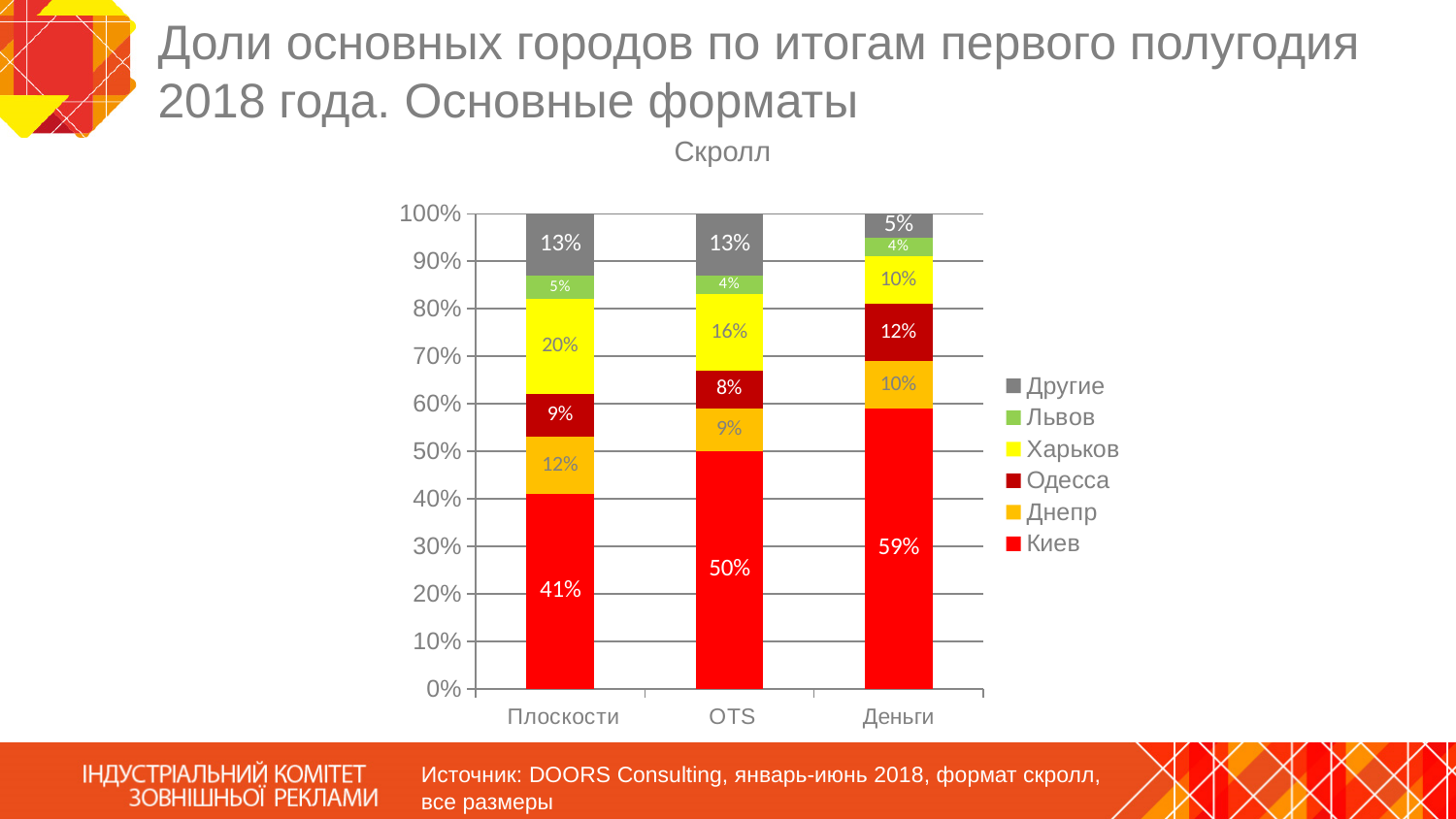
What is the share of Другие in the Деньги bar? 5% Does the Киев share rise or fall from Плоскости to Деньги? Rise How many categories are shown on the x axis? 3 What kind of chart is shown on the slide? Stacked bar chart What is the share of Киев in the Деньги bar? 59% In which category does Харьков have the lowest share? Деньги How many series does the legend list? 6 In which category does Киев have the highest share? Деньги What is the share of Харьков in the Плоскости bar? 20% Which is larger: the Днепр share in Плоскости or the Днепр share in OTS? Плоскости What is the share of Одесса in the OTS bar? 8% What is the difference between the Киев share in Деньги and in Плоскости? 18%